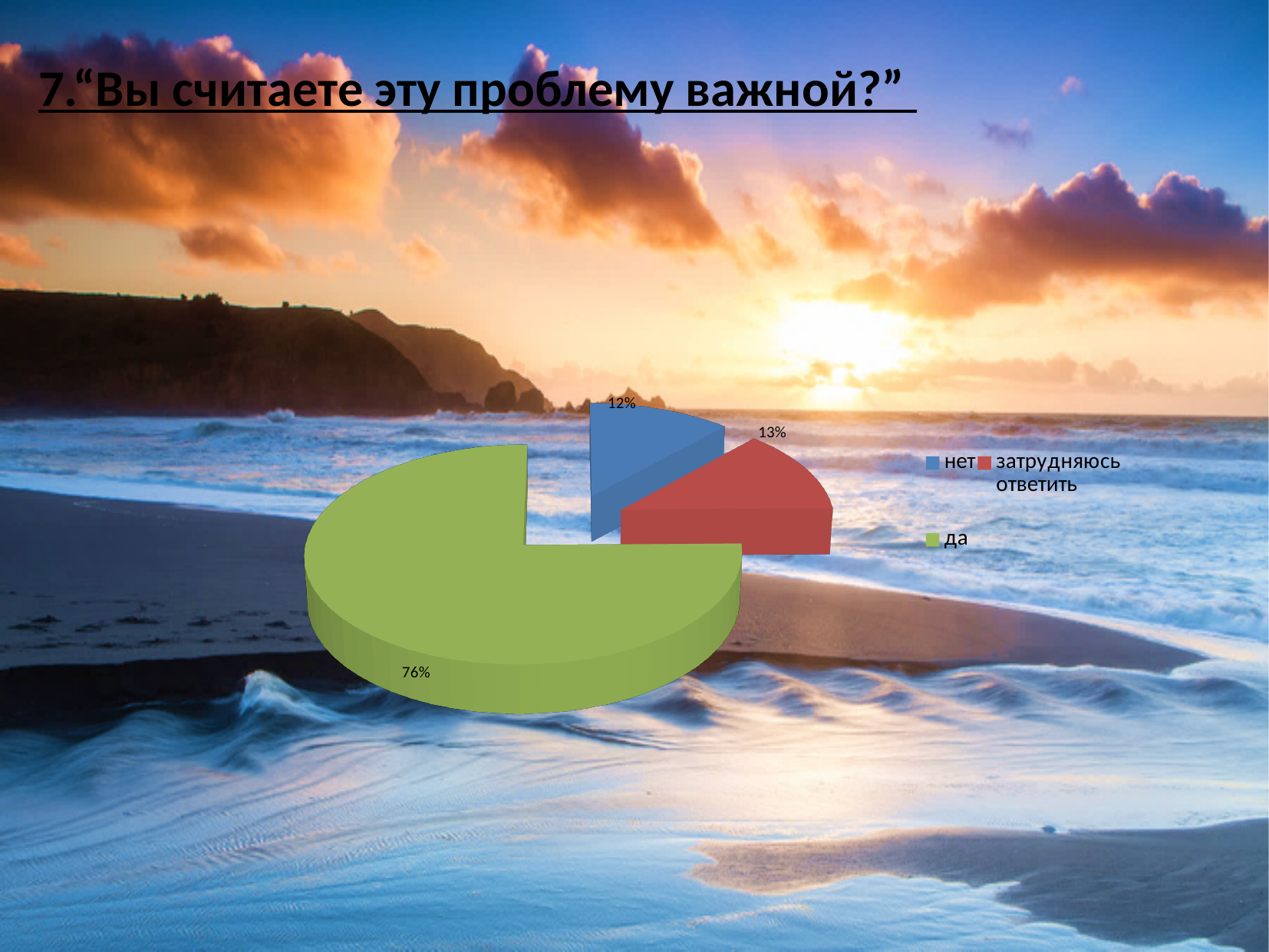
What is the difference in percentage points between the "да" slice and the "нет" slice? 64 How many slices does the pie chart have? 3 Which is larger, the share for "нет" or the share for "затрудняюсь ответить"? затрудняюсь ответить What is the title of the slide above the chart? 7."Вы считаете эту проблему важной?" What share of the pie does the "затрудняюсь ответить" slice represent? 13% What share of the pie does the "нет" slice represent? 12% What colour is the "да" slice in the pie chart? green What kind of chart is shown on the slide? pie chart Which category has the largest slice of the pie? да What share of the pie does the "да" slice represent? 76% How many entries does the legend list? 3 Which category has the smallest slice of the pie? нет